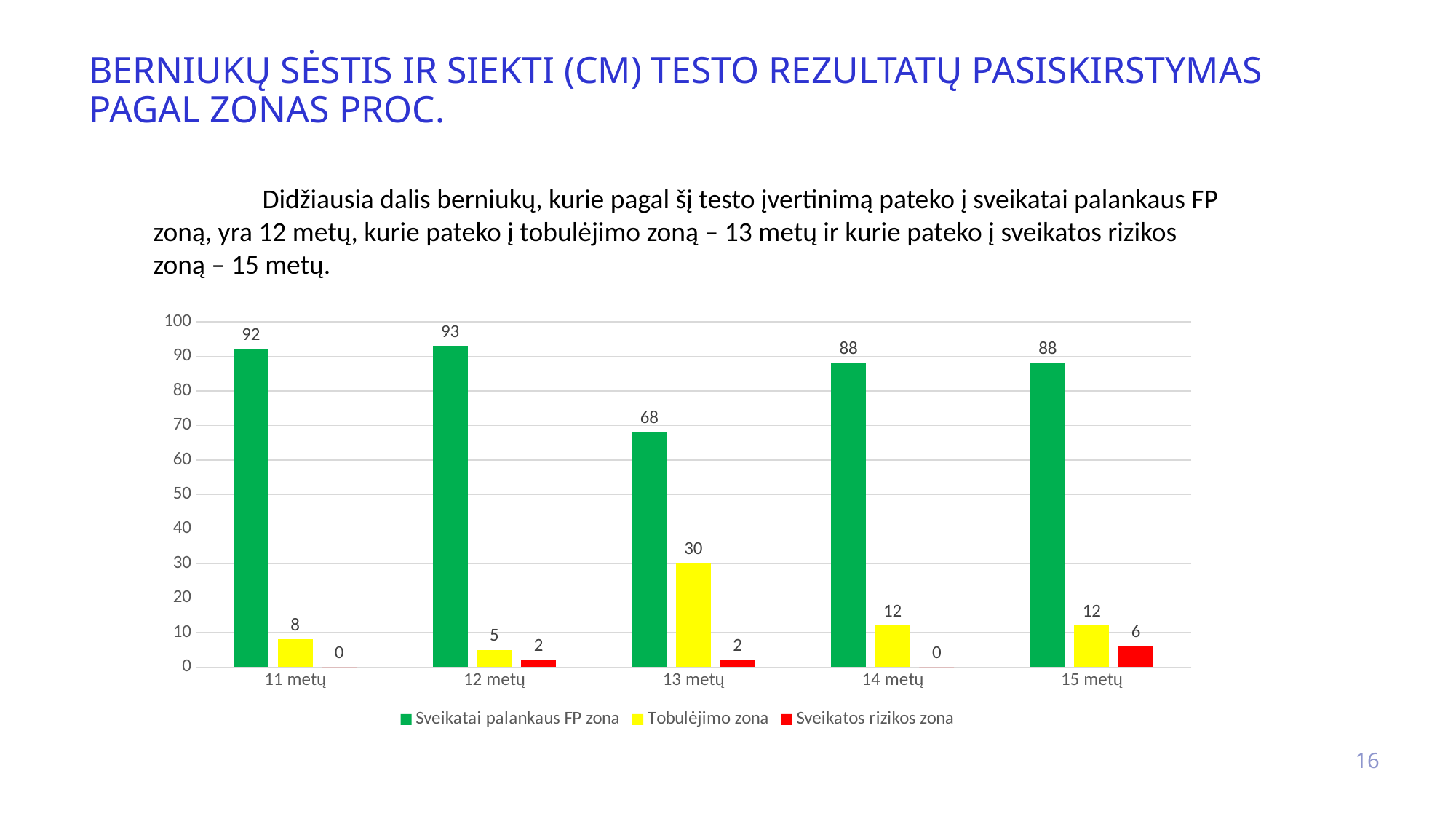
What is the value for Sveikatos rizikos zona at 15 metų? 6 Which age group has the highest value for Tobulėjimo zona? 13 metų What is the value for Tobulėjimo zona at 13 metų? 30 What is the value for Sveikatai palankaus FP zona at 12 metų? 93 Which age group has the highest value for Sveikatai palankaus FP zona? 12 metų Which is larger: Tobulėjimo zona at 11 metų or at 12 metų? 11 metų How many series does the legend list? 3 What kind of chart is shown on the slide? bar chart Which age group has the lowest value for Sveikatai palankaus FP zona? 13 metų How many age groups are shown on the x axis? 5 Is the value for Sveikatai palankaus FP zona at 13 metų greater or less than 70? less What is the difference between the Sveikatai palankaus FP zona values at 12 metų and 13 metų? 25